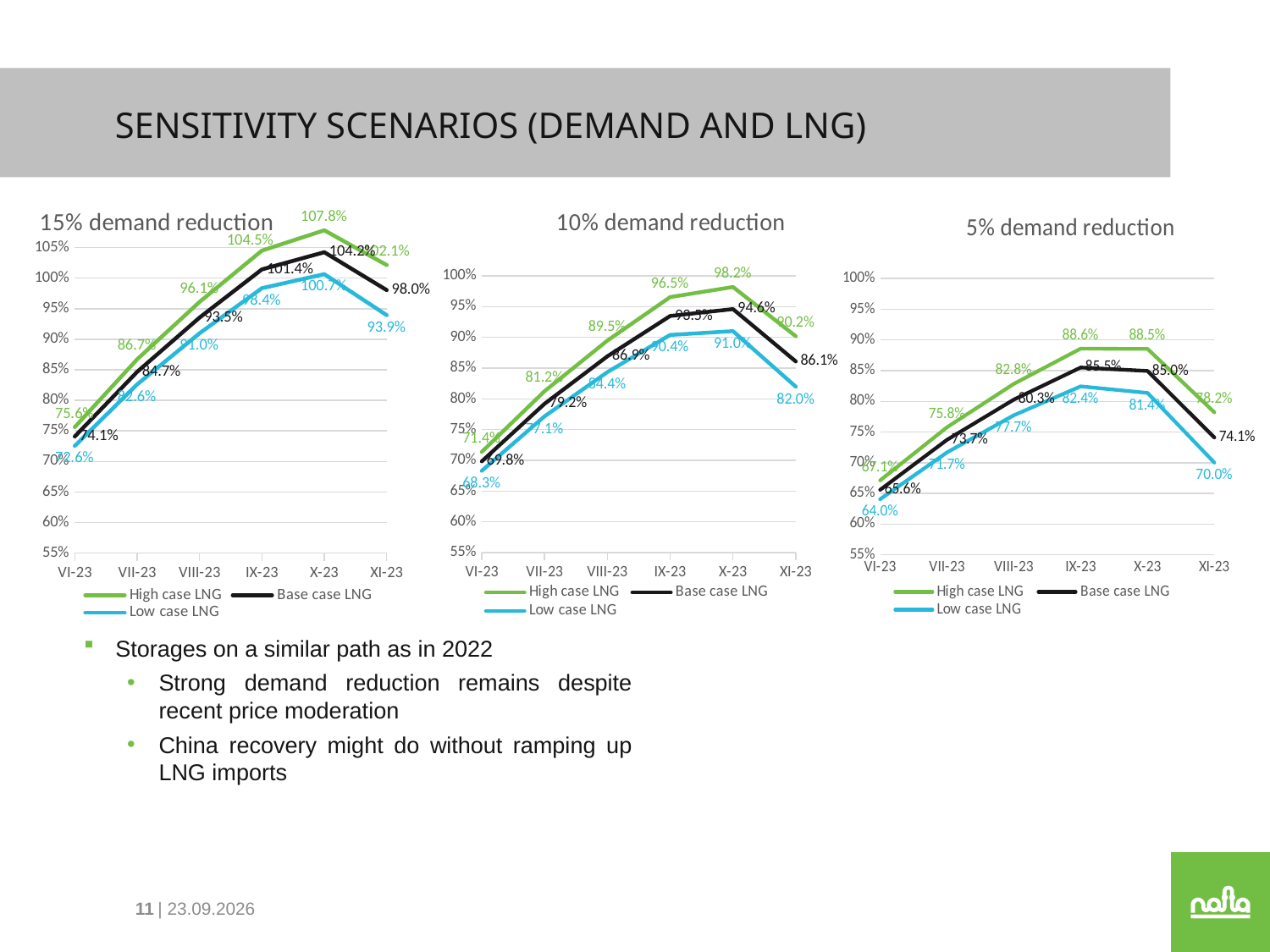
In the '5% demand reduction' chart, what is the value of the High case LNG series at IX-23? 88.6% What kind of chart is the '10% demand reduction' chart? Line chart How many series does the legend of the '5% demand reduction' chart list? 3 In the '15% demand reduction' chart, what is the value of the High case LNG series at X-23? 107.8% In the '5% demand reduction' chart, does the Base case LNG series rise or fall from VI-23 to IX-23? Rise How many months are shown on the x axis of the '15% demand reduction' chart? 6 In the '15% demand reduction' chart, what is the value of the Base case LNG series at XI-23? 98.0% In the '10% demand reduction' chart, at which month does the High case LNG series reach its highest value? X-23 In the '10% demand reduction' chart, which is larger at XI-23: the High case LNG value or the Base case LNG value? High case LNG In the '10% demand reduction' chart, what is the value of the Low case LNG series at VI-23? 68.3% In the '15% demand reduction' chart, what is the difference between the High case LNG and Low case LNG values at X-23? 7.1% In the '5% demand reduction' chart, what is the value of the Low case LNG series at XI-23? 70.0%